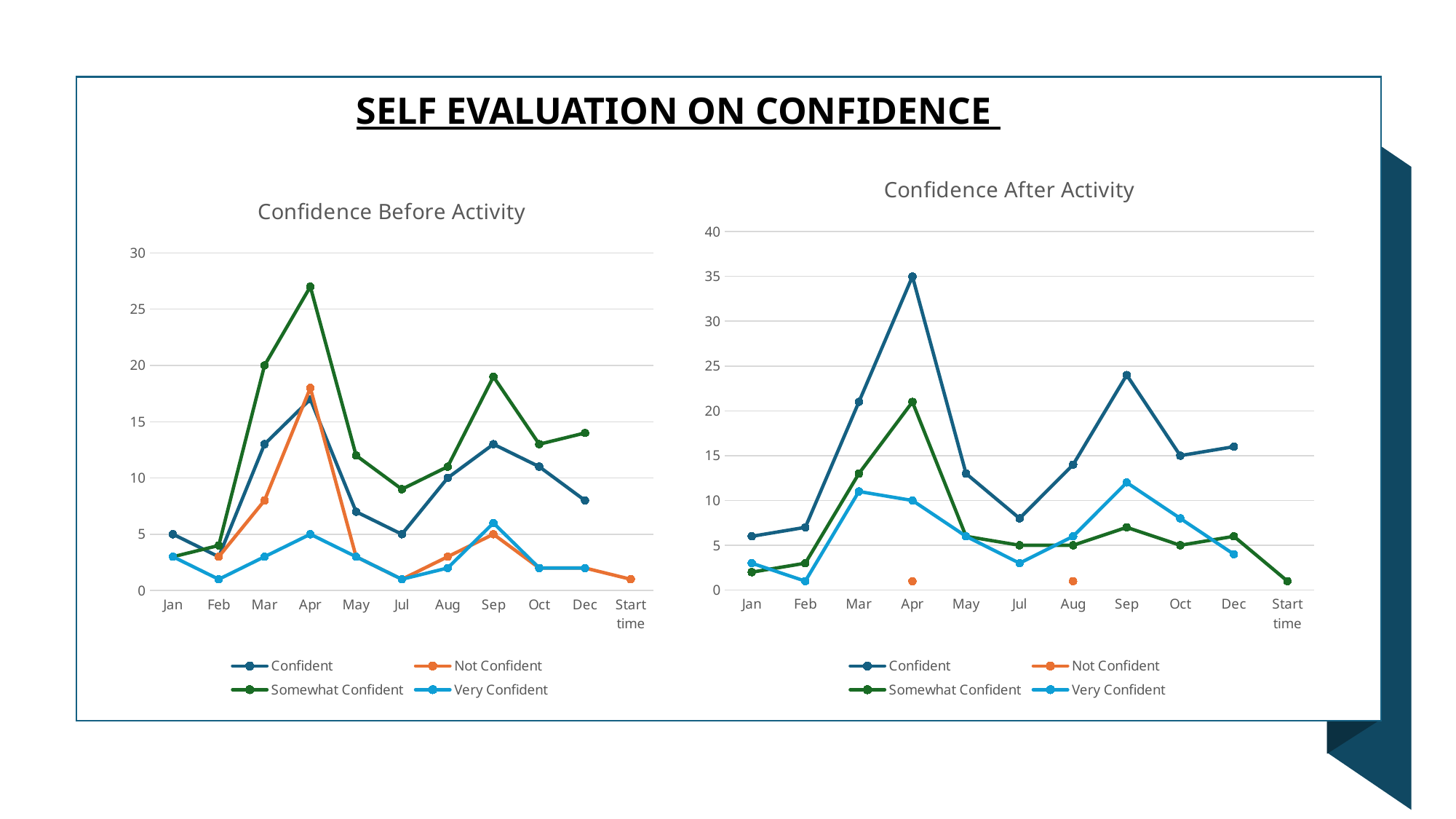
In the "Confidence After Activity" chart, does the Confident series rise or fall from Apr to Jul? fall In the "Confidence After Activity" chart, is the value for Confident in Sep greater or less than 20? greater In the "Confidence After Activity" chart, is the value for Very Confident in Jul greater or less than 5? less In the "Confidence Before Activity" chart, in which month does the Somewhat Confident series reach its highest value? Apr In the "Confidence After Activity" chart, in which month does the Confident series reach its highest value? Apr What kind of chart is the "Confidence Before Activity" chart? line chart How many series does the legend of the "Confidence After Activity" chart list? 4 In the "Confidence Before Activity" chart, which is larger in Sep: Somewhat Confident or Confident? Somewhat Confident How many categories are shown on the x axis of the "Confidence Before Activity" chart? 11 In the "Confidence After Activity" chart, which is larger in Mar: Confident or Very Confident? Confident What is the title of the chart on the right side of the slide? Confidence After Activity In the "Confidence Before Activity" chart, is the value for Somewhat Confident in Apr greater or less than 25? greater